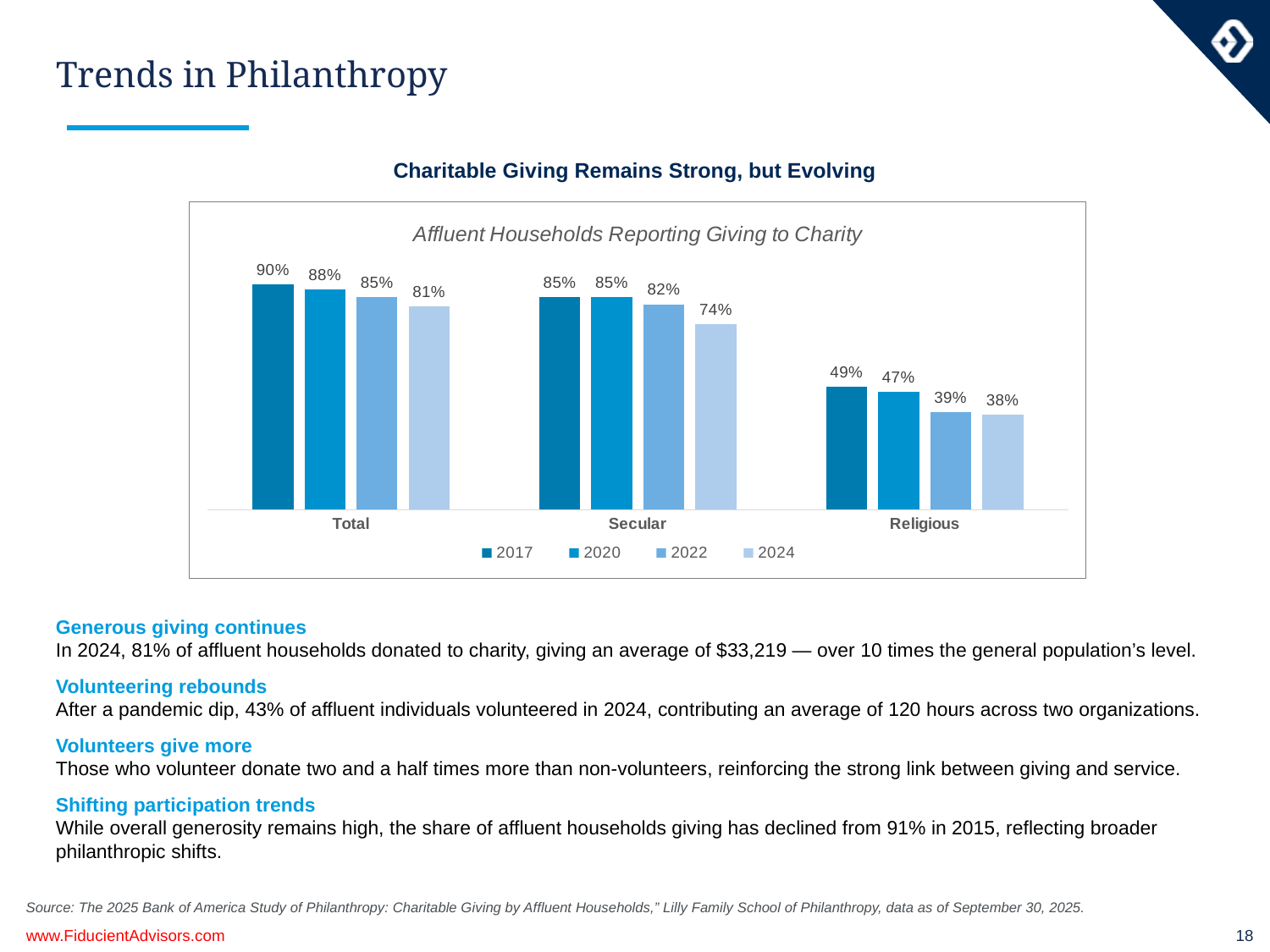
What is the value for Secular in 2022? 82% Which category has the lowest value in 2024? Religious How many series does the legend list? 4 What kind of chart is shown? Bar chart How many categories are shown on the x axis? 3 What is the difference between the Total values for 2017 and 2024? 9% What is the value for Religious in 2017? 49% What is the value for Total in 2024? 81% Which year has the highest value for Total? 2017 Do the Religious values rise or fall from 2017 to 2024? Fall What is the difference between the Secular values for 2022 and 2024? 8% Which is larger, the Religious value for 2020 or the Religious value for 2022? 2020